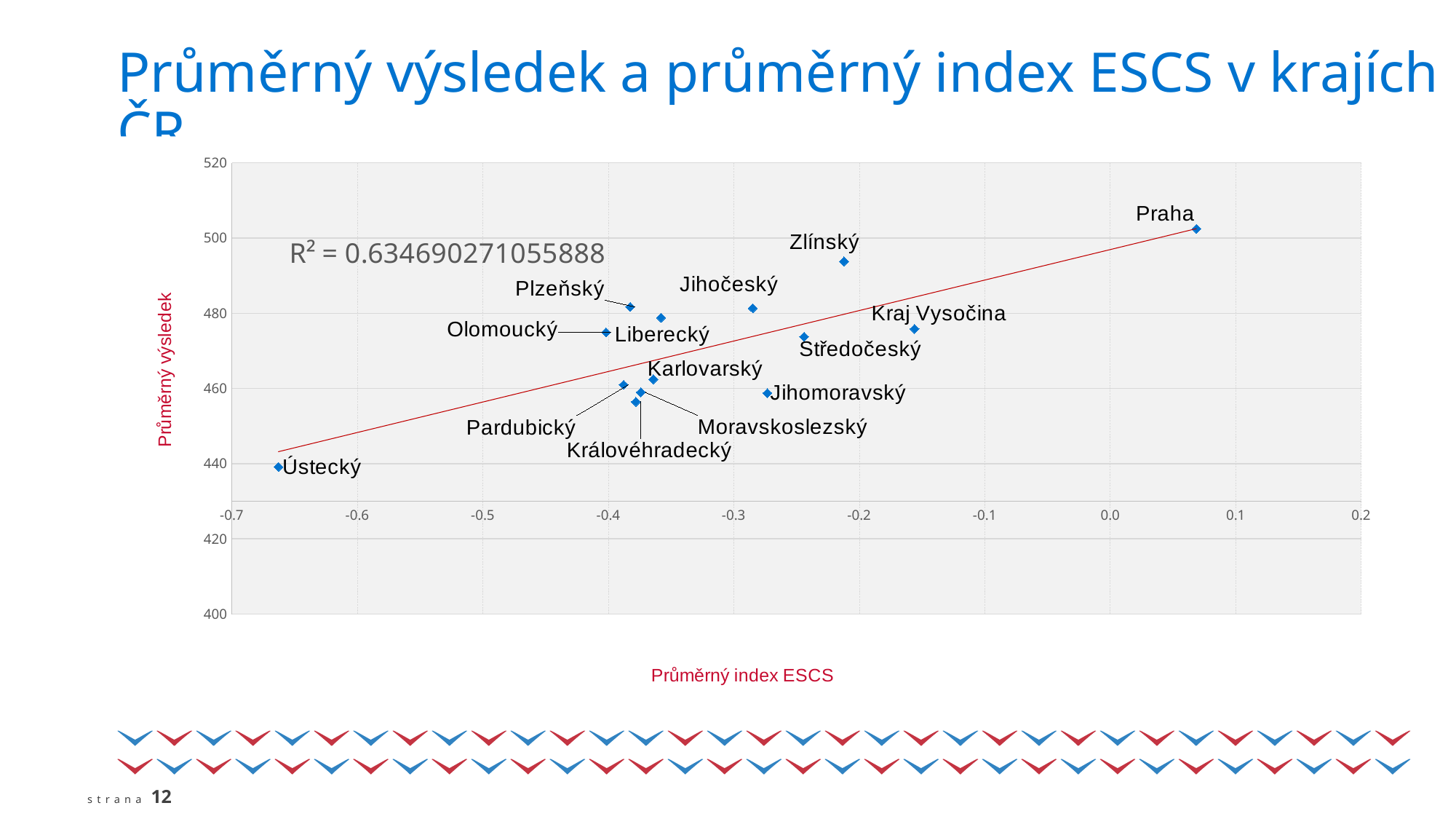
Which region has the lowest average result (Průměrný výsledek)? Ústecký Is the average ESCS index for Praha greater or less than 0.0? greater What R² value is printed on the chart? R² = 0.634690271055888 What is the title of the x axis? Průměrný index ESCS What kind of chart is shown on the slide? scatter chart Which region has the highest average result (Průměrný výsledek)? Praha Does the trend line show the average result rising or falling as the ESCS index increases? rising Is the average result for Zlínský greater or less than 480? greater How many regions (data points) are plotted on the chart? 14 Which region has a higher average result, Zlínský or Jihočeský? Zlínský Which region has the lowest average ESCS index? Ústecký Is the average ESCS index for Ústecký greater or less than -0.6? less